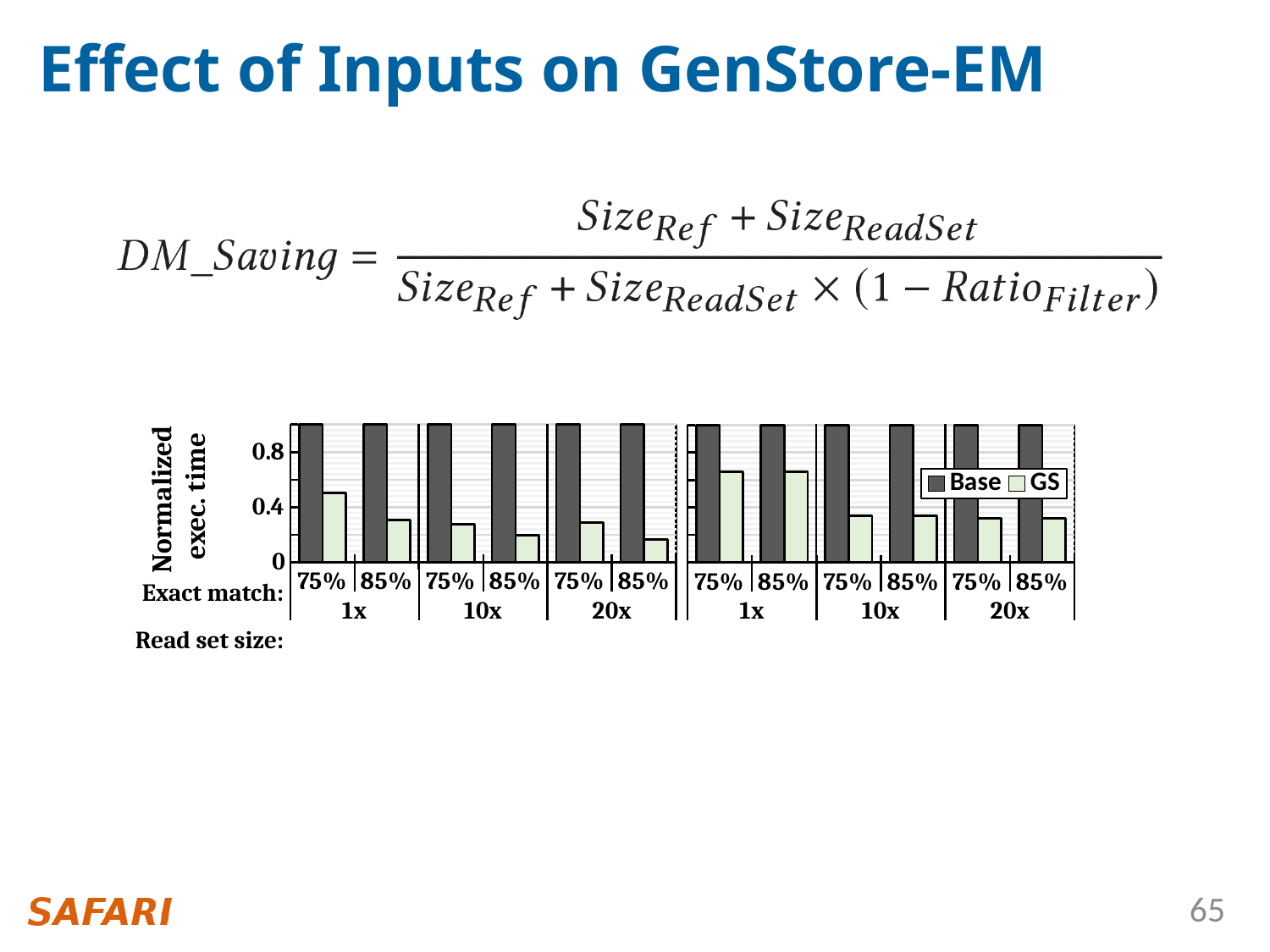
What are the two series named in the chart legend? Base and GS How many read set size groups (1x, 10x, 20x) are shown in the left panel of the chart? 3 What kind of chart is shown on the slide? bar chart In the right panel, is the GS value for 10x read set size with 75% exact match greater or less than 0.4? less In the left panel, is the GS value for 1x read set size with 75% exact match greater or less than 0.4? greater In the left panel, is the GS value for 20x read set size with 85% exact match greater or less than 0.4? less In the right panel, do the GS values rise or fall as the read set size increases from 1x to 20x? fall In the left panel, which is larger for 1x read set size: the GS value at 75% exact match or at 85% exact match? 75% exact match In the left panel, which GS bar is the highest? 1x read set size, 75% exact match What is the label of the chart's y axis? Normalized exec. time How many series does the chart legend list? 2